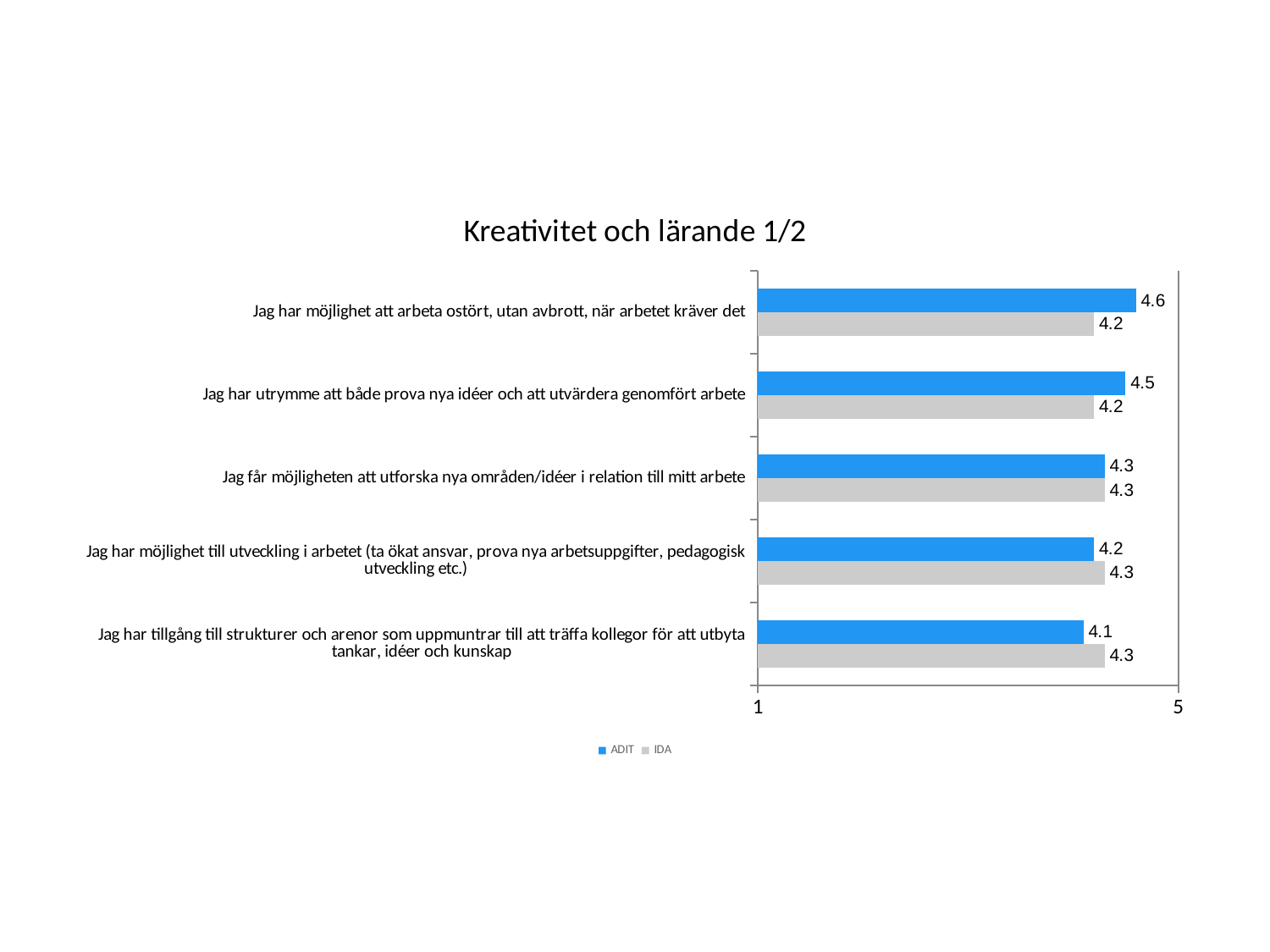
Which category has the highest ADIT value? Jag har möjlighet att arbeta ostört, utan avbrott, när arbetet kräver det Which category has the lowest ADIT value? Jag har tillgång till strukturer och arenor som uppmuntrar till att träffa kollegor för att utbyta tankar, idéer och kunskap What is the difference between the ADIT and IDA values for "Jag har möjlighet att arbeta ostört, utan avbrott, när arbetet kräver det"? 0.4 What is the ADIT value for "Jag har möjlighet att arbeta ostört, utan avbrott, när arbetet kräver det"? 4.6 How many series does the legend list? 2 What is the title of the chart? Kreativitet och lärande 1/2 What kind of chart is shown on the slide? Bar chart How many categories are shown in the chart? 5 Which series is shown in blue? ADIT What is the ADIT value for "Jag har tillgång till strukturer och arenor som uppmuntrar till att träffa kollegor för att utbyta tankar, idéer och kunskap"? 4.1 What is the IDA value for "Jag har utrymme att både prova nya idéer och att utvärdera genomfört arbete"? 4.2 For "Jag har möjlighet till utveckling i arbetet (ta ökat ansvar, prova nya arbetsuppgifter, pedagogisk utveckling etc.)", which series has the larger value, ADIT or IDA? IDA